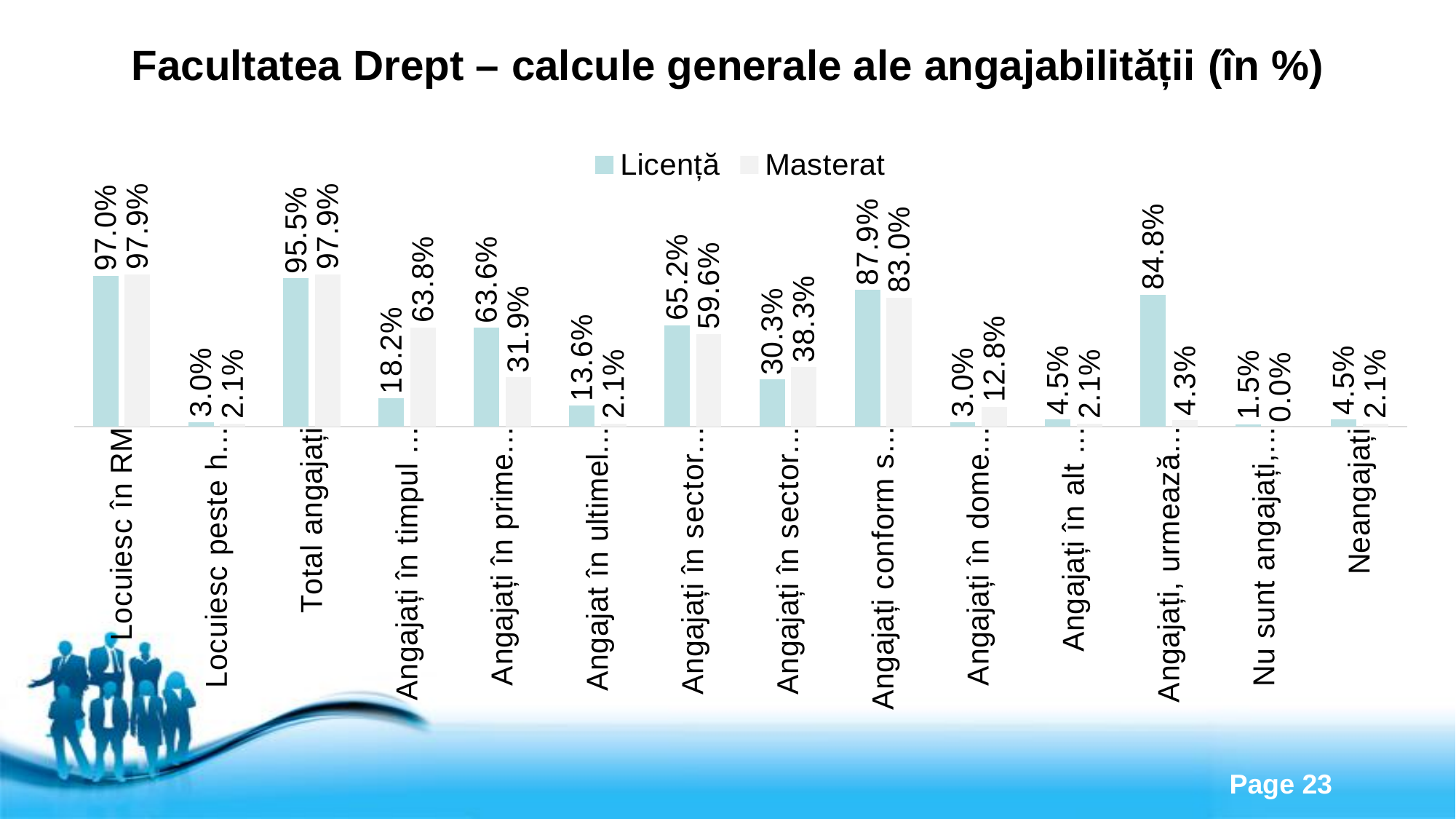
For Neangajați, which series has the larger value, Licență or Masterat? Licență Which category has the highest Licență value? Locuiesc în RM What is the difference between the Masterat and Licență values for Total angajați? 2.4% What is the Licență value for Neangajați? 4.5% How many series does the legend list? 2 What is the Licență value for Locuiesc în RM? 97.0% What is the Masterat value for Total angajați? 97.9% What are the two series named in the legend? Licență and Masterat Which category has the lowest Masterat value? Nu sunt angajați,... What kind of chart is shown on the slide? Bar chart How many categories are shown on the x axis? 14 What is the Masterat value for Neangajați? 2.1%